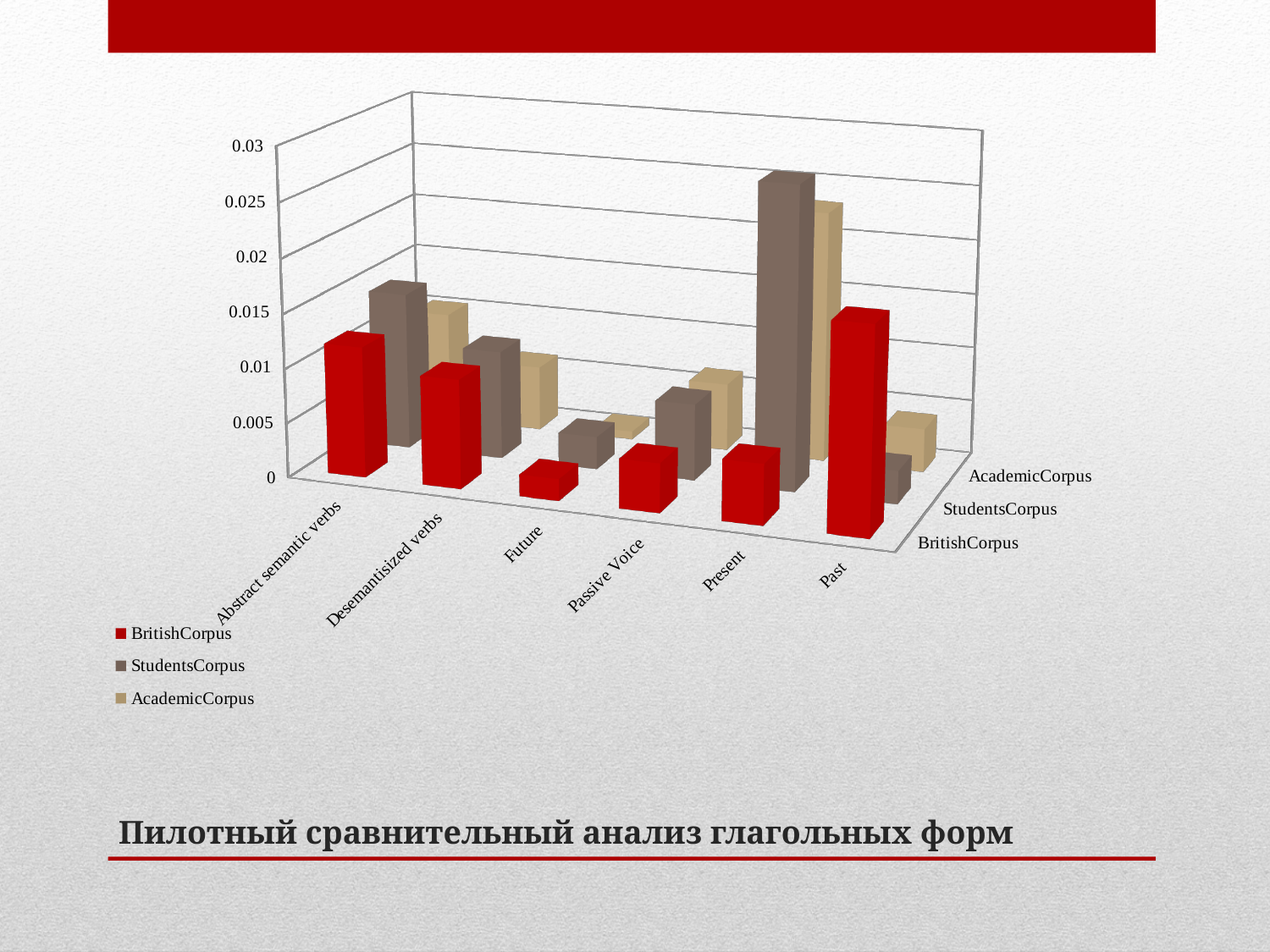
Is the StudentsCorpus value for Past greater or less than 0.02? less For the Past category, which is larger: the StudentsCorpus bar or the AcademicCorpus bar? AcademicCorpus Which category has the lowest bar for the BritishCorpus series? Future For the BritishCorpus series, which is larger: the Past bar or the Future bar? Past Which category has the tallest bar for the StudentsCorpus series? Present How many series does the chart's legend list? 3 Which colour represents the BritishCorpus series in the legend? red Which category has the highest bar for the BritishCorpus series? Past Is the BritishCorpus value for Abstract semantic verbs greater or less than 0.005? greater What kind of chart is shown on the slide? bar chart Is the BritishCorpus value for Future greater or less than 0.005? less How many categories are shown along the x axis of the chart? 6